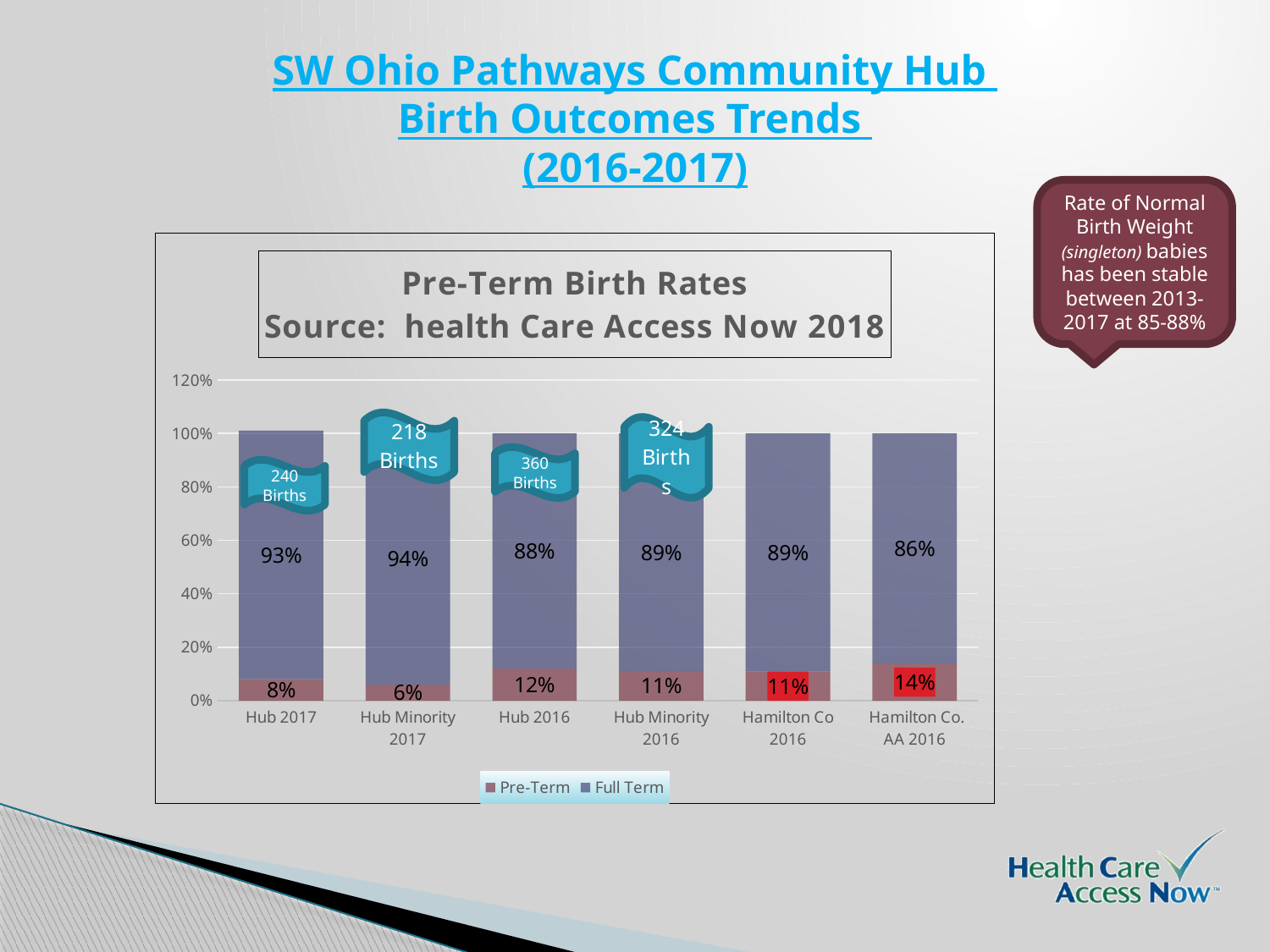
What is the difference between the Pre-Term values for Hub 2016 and Hub 2017? 4% What is the total of the stacked bar for Hub 2016? 100% Which category has the highest Pre-Term value? Hamilton Co. AA 2016 What is the Full Term value for Hub 2016? 88% What is the Pre-Term value for Hub 2017? 8% Which is larger, the Full Term value for Hub 2017 or for Hamilton Co. AA 2016? Hub 2017 How many categories are shown on the x axis? 6 How many series does the legend list? 2 What kind of chart is this? Stacked bar chart Which category has the lowest Pre-Term value? Hub Minority 2017 What is the Pre-Term value for Hamilton Co. AA 2016? 14% What is the Full Term value for Hub Minority 2017? 94%